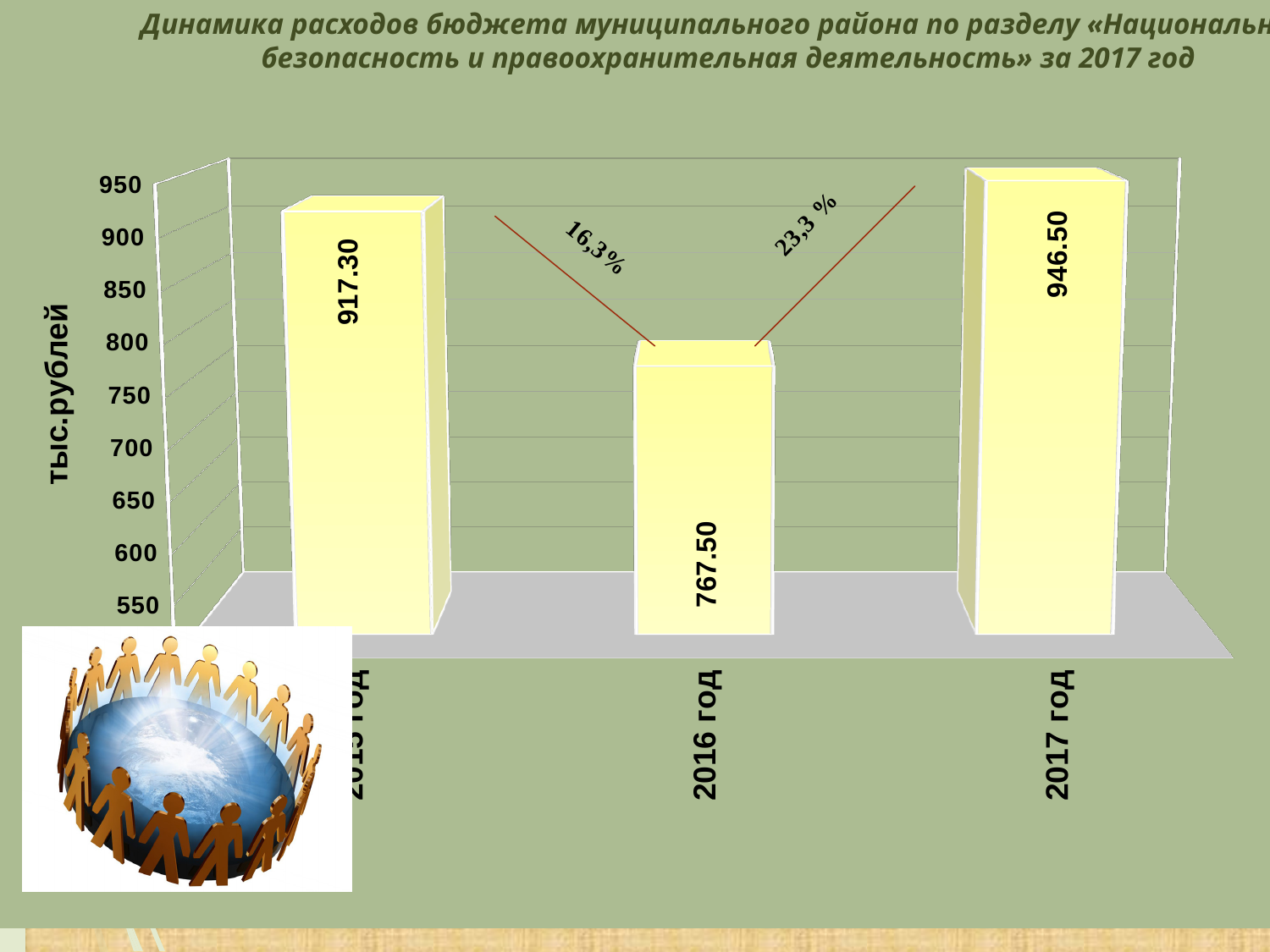
What is the value for 2016 год? 767.50 Which is larger: the value for 2017 год or the value of the leftmost bar? 2017 год What is the difference between the values for 2017 год and 2016 год? 179.00 What kind of chart is shown on the slide? bar chart What is the value shown on the leftmost bar? 917.30 What is the value for 2017 год? 946.50 How many bars are shown in the chart? 3 Which year has the lowest value? 2016 год What is the label on the vertical axis of the chart? тыс.рублей Which year has the highest value? 2017 год Is the value for 2016 год greater or less than 800? less What is the difference between the leftmost bar's value and the value for 2016 год? 149.80